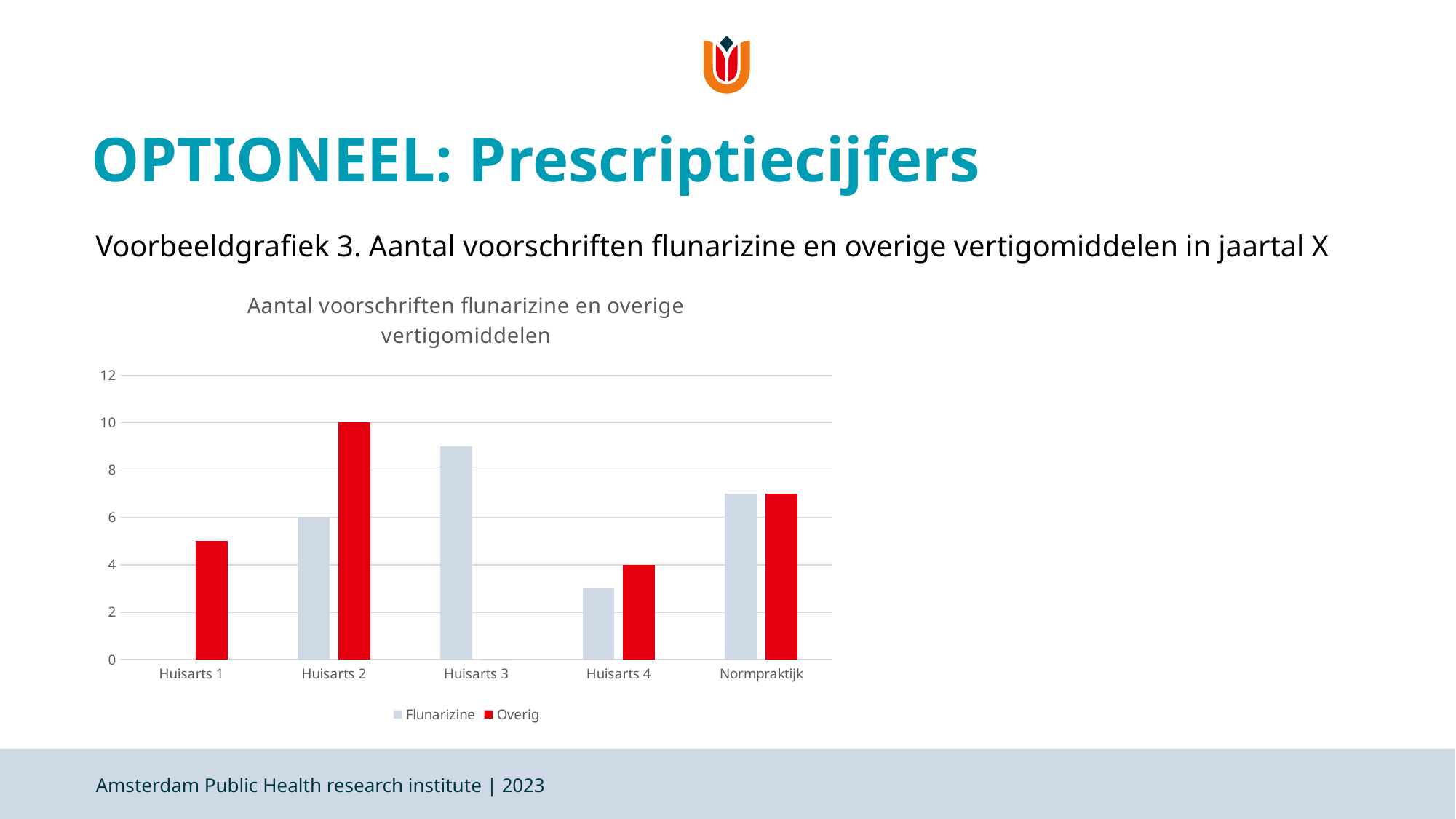
What is the Overig value for Huisarts 2? 10 What is the Flunarizine value for Huisarts 2? 6 What is the Overig value for Huisarts 4? 4 What is the difference between the Overig and Flunarizine values for Huisarts 2? 4 How many categories are shown on the x axis? 5 What kind of chart is shown on the slide? Bar chart For Huisarts 4, which series has the larger value, Flunarizine or Overig? Overig How many series does the legend list? 2 Which category has the highest Overig value? Huisarts 2 Which category has the highest Flunarizine value? Huisarts 3 Is the Flunarizine value for Huisarts 3 greater or less than 8? greater Is the Overig value for Huisarts 1 greater or less than 4? greater